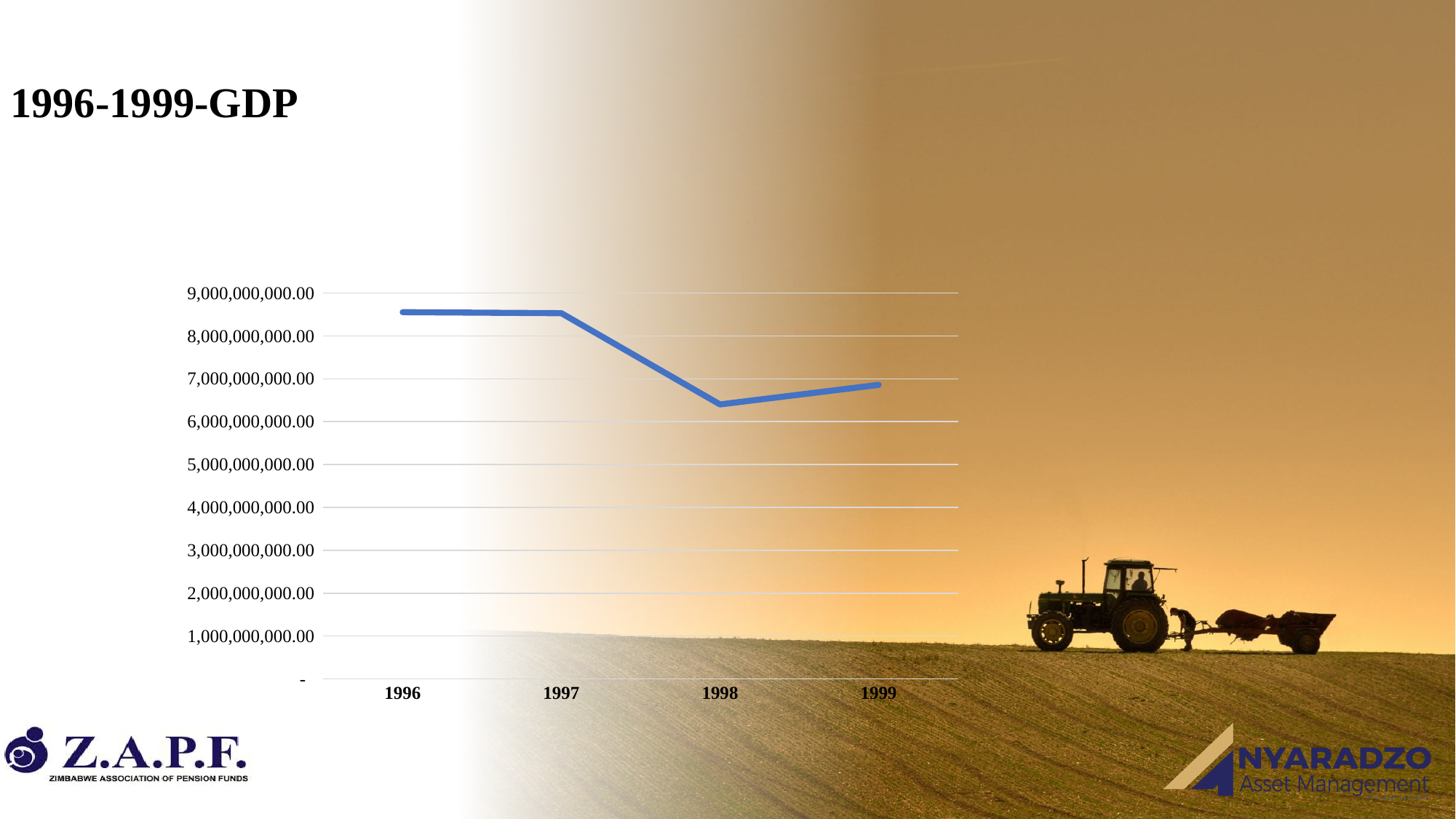
Is the GDP value for 1996 greater or less than 8,000,000,000.00? greater Which year has the larger GDP value, 1997 or 1998? 1997 Which year has the lowest GDP value in the chart? 1998 Which year has the larger GDP value, 1998 or 1999? 1999 Is the GDP value for 1999 greater or less than 6,000,000,000.00? greater Does the GDP value rise or fall between 1997 and 1998? fall What is the title shown on the slide above the chart? 1996-1999-GDP What kind of chart is shown on the slide? line chart Is the GDP value for 1997 greater or less than 9,000,000,000.00? less How many years are plotted on the x axis of the chart? 4 Overall, is the GDP value in 1999 higher or lower than in 1996? lower